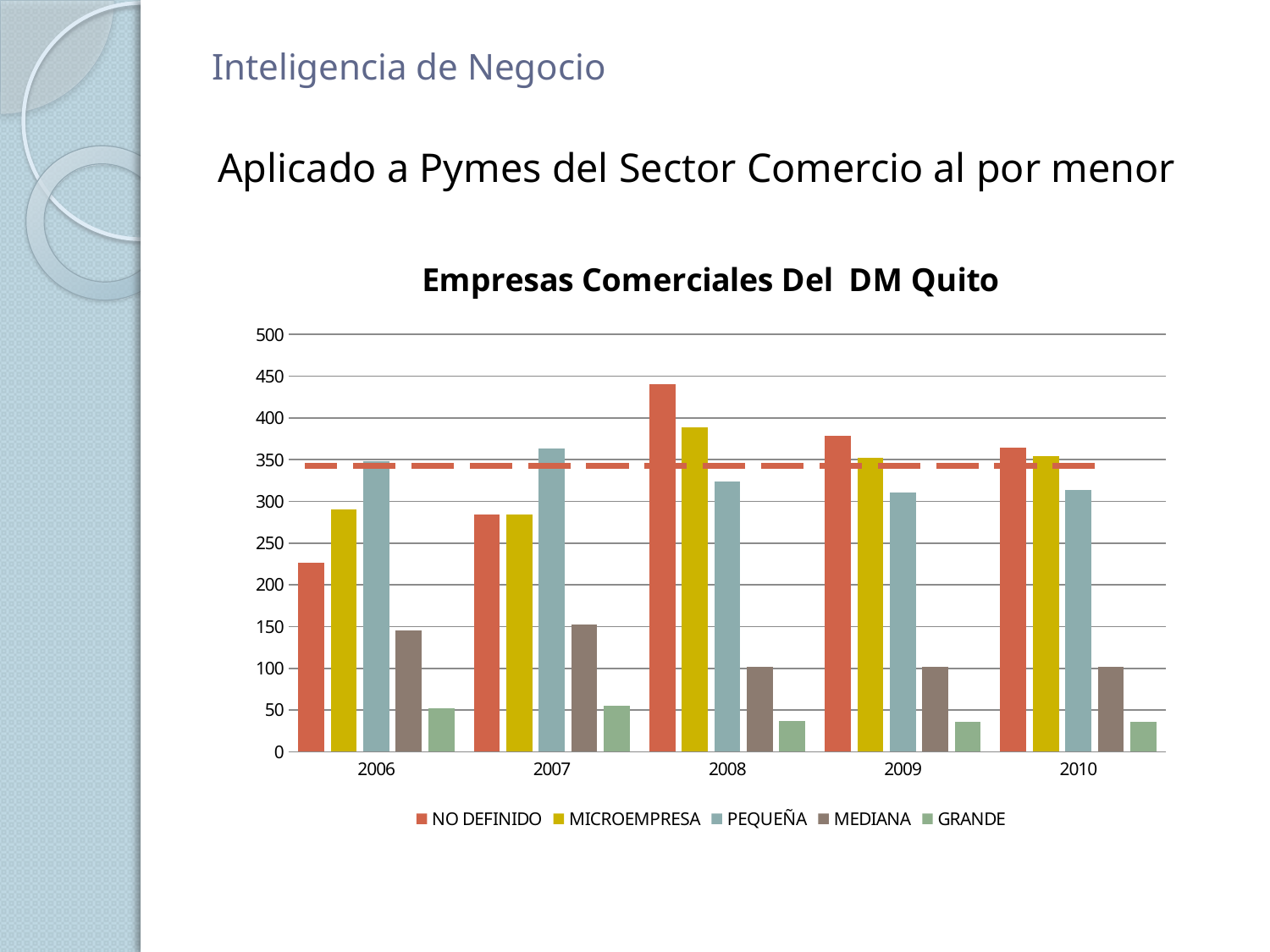
How many series does the legend list? 5 Is the value for GRANDE in 2010 greater or less than 50? less How many years are shown on the x axis? 5 What kind of chart is shown on the slide? bar chart What is the title of the chart? Empresas Comerciales Del DM Quito Is the value for MEDIANA in 2006 greater or less than 100? greater Is the value for NO DEFINIDO in 2008 greater or less than 400? greater Does the GRANDE series rise or fall from 2006 to 2010? fall In 2008, which is larger: NO DEFINIDO or MICROEMPRESA? NO DEFINIDO In 2006, which is larger: PEQUEÑA or NO DEFINIDO? PEQUEÑA In which year is the NO DEFINIDO bar the highest? 2008 Which series has the lowest bar in 2008? GRANDE